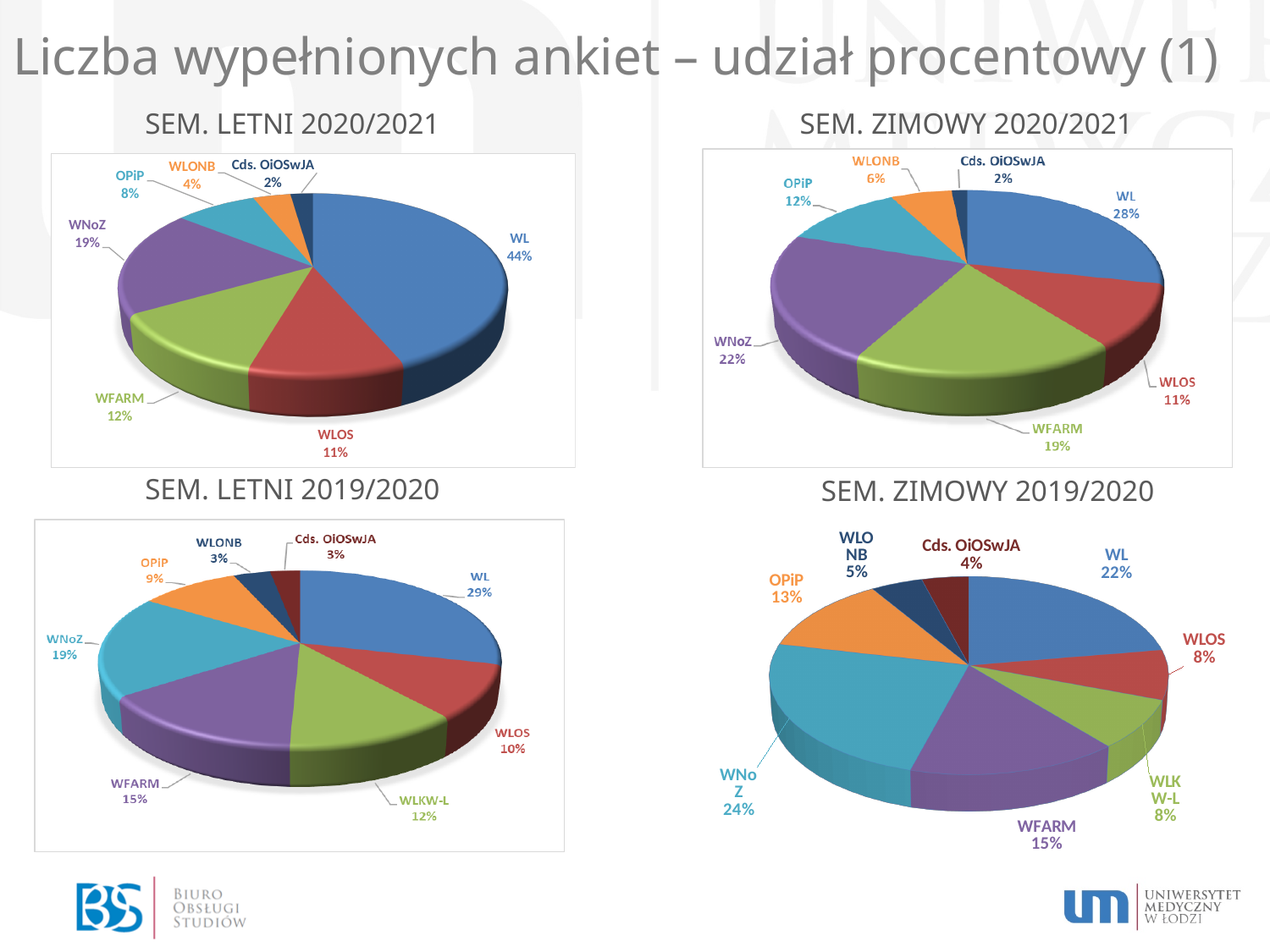
In the SEM. LETNI 2019/2020 chart, what share does WFARM have? 15% In the SEM. LETNI 2019/2020 chart, which is larger, the share of WNoZ or the share of WFARM? WNoZ How many charts are shown on the slide? 4 What type of chart is used for SEM. LETNI 2020/2021? Pie chart In the SEM. LETNI 2020/2021 chart, what share does WL have? 44% How many slices does the SEM. LETNI 2019/2020 pie chart have? 8 In the SEM. ZIMOWY 2019/2020 chart, what share does OPiP have? 13% In the SEM. LETNI 2020/2021 chart, which category has the smallest share? Cds. OiOSwJA In the SEM. ZIMOWY 2020/2021 chart, what share does WNoZ have? 22% In the SEM. ZIMOWY 2020/2021 chart, what is the difference between the shares of WL and WLOS? 17% In the SEM. ZIMOWY 2019/2020 chart, which category has the largest share? WNoZ How many slices does the SEM. ZIMOWY 2020/2021 pie chart have? 7